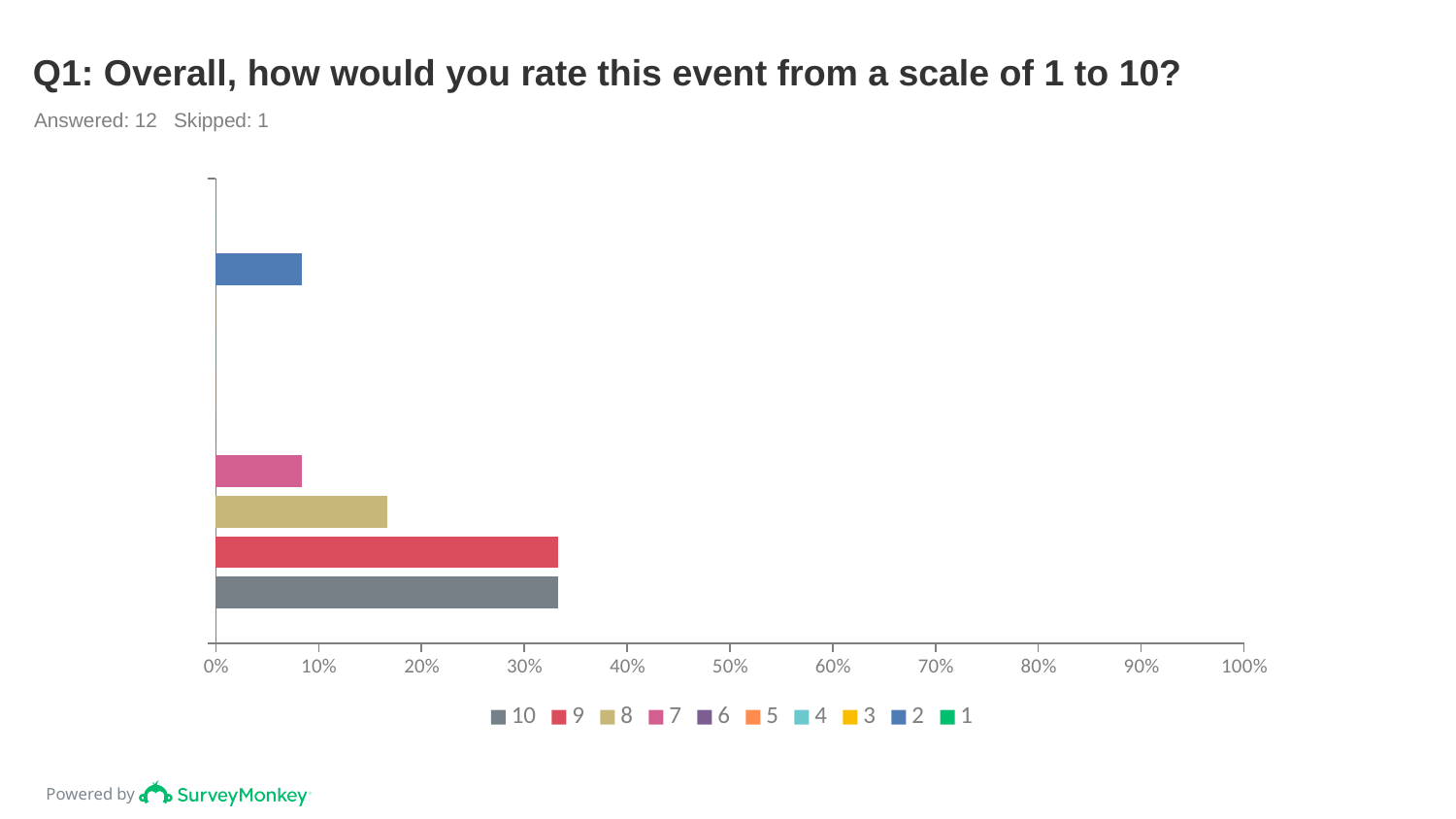
Is the value for rating 2 greater or less than 10%? less Is the value for rating 8 greater or less than 20%? less Which is larger, the value for rating 9 or the value for rating 8? 9 Is the value for rating 8 greater or less than 10%? greater Which is larger, the value for rating 8 or the value for rating 7? 8 How many bars are drawn on the chart? 5 What kind of chart is shown on the slide? bar chart How many entries does the legend list? 10 How many respondents answered the question according to the slide? 12